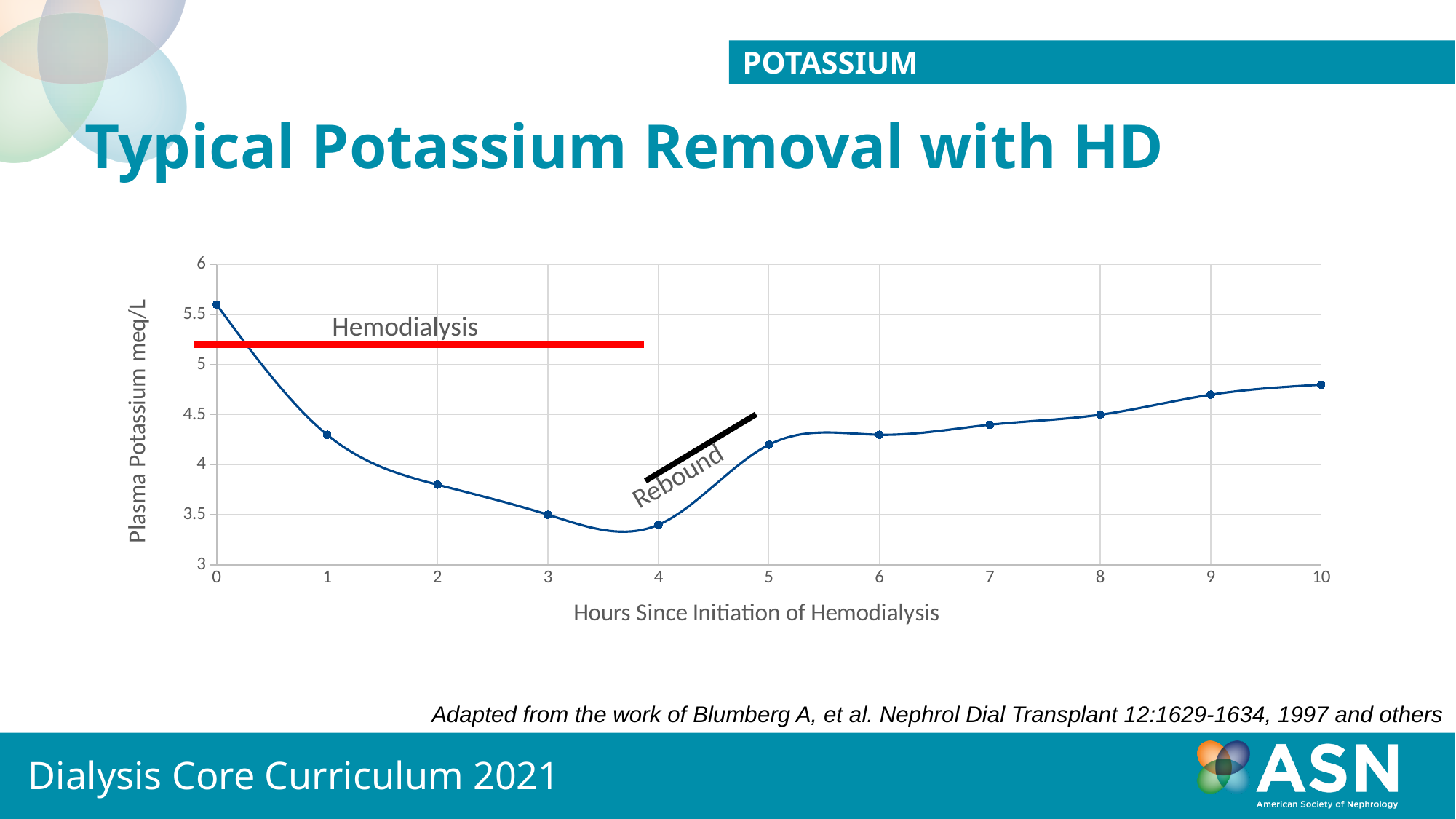
Does plasma potassium rise or fall between hour 0 and hour 4? fall At which hour since initiation of hemodialysis is plasma potassium lowest? 4 At which hour since initiation of hemodialysis is plasma potassium highest? 0 How many data points are plotted on the line? 11 Is the plasma potassium value at hour 0 greater or less than 5 meq/L? greater Is the plasma potassium value at hour 5 greater or less than 4 meq/L? greater Is the plasma potassium value at hour 10 greater or less than 5 meq/L? less What is the title of the x axis? Hours Since Initiation of Hemodialysis What kind of chart is shown on the slide? line chart What label is written above the red horizontal bar on the chart? Hemodialysis Which has the higher plasma potassium value: hour 0 or hour 10? hour 0